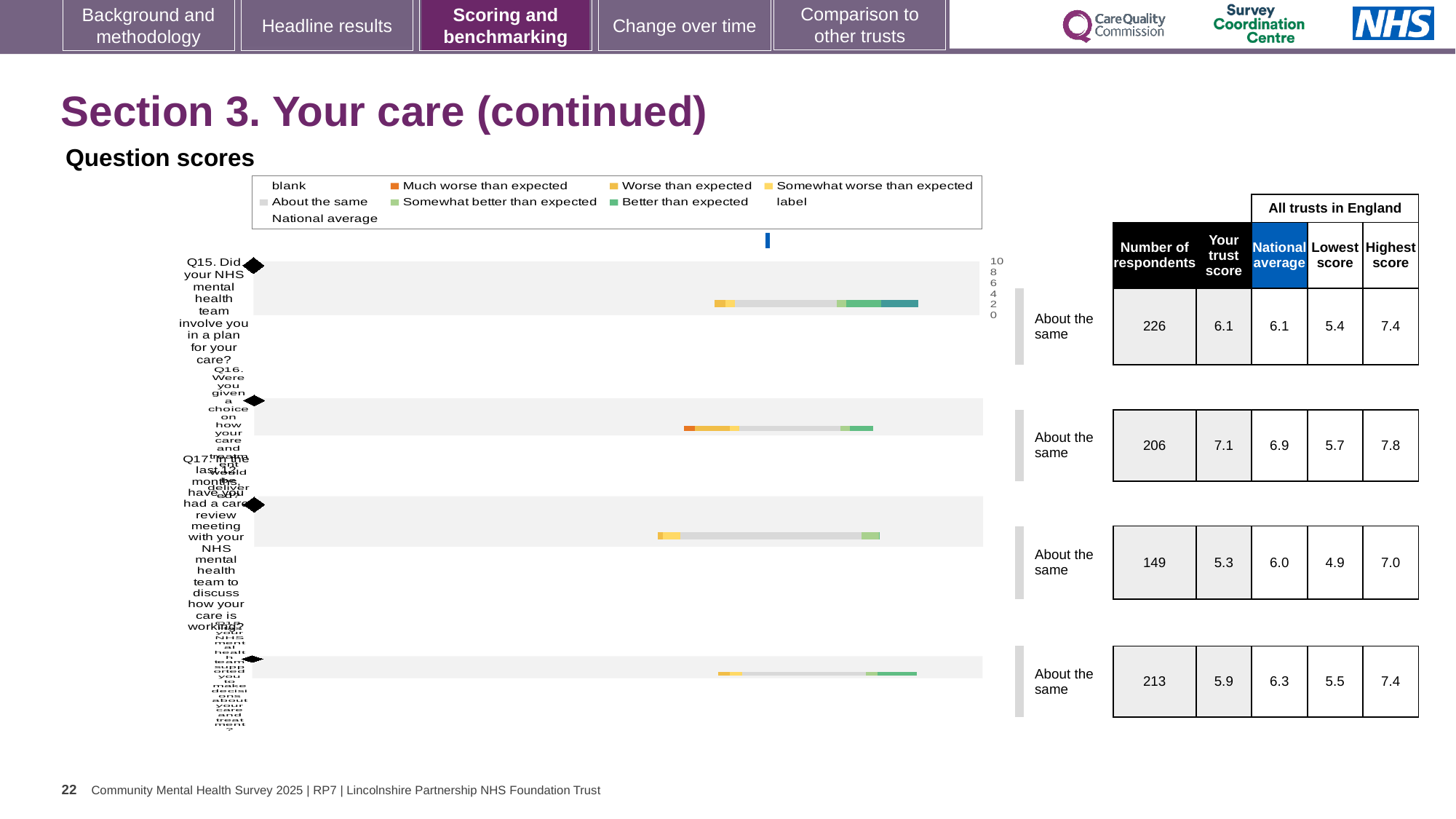
In the table beside the chart, what is the number of respondents for Q15? 226 How many question bars are plotted in the question scores chart? 4 In the table beside the chart, what is the trust score for Q16? 7.1 For Q16, is the trust score or the national average larger? trust score Which question has the fewest respondents in the table beside the chart? Q17 In the table beside the chart, what is the highest score among all trusts in England for Q16? 7.8 In the table beside the chart, what is the national average for Q17? 6.0 What benchmark category is shown next to the chart for Q15? About the same What kind of chart is used to show the question scores on this slide? bar chart What is the difference between the national average and the trust score for Q17? 0.7 In the table beside the chart, what is the lowest score among all trusts in England for Q17? 4.9 Which question has the highest trust score in the table beside the chart? Q16